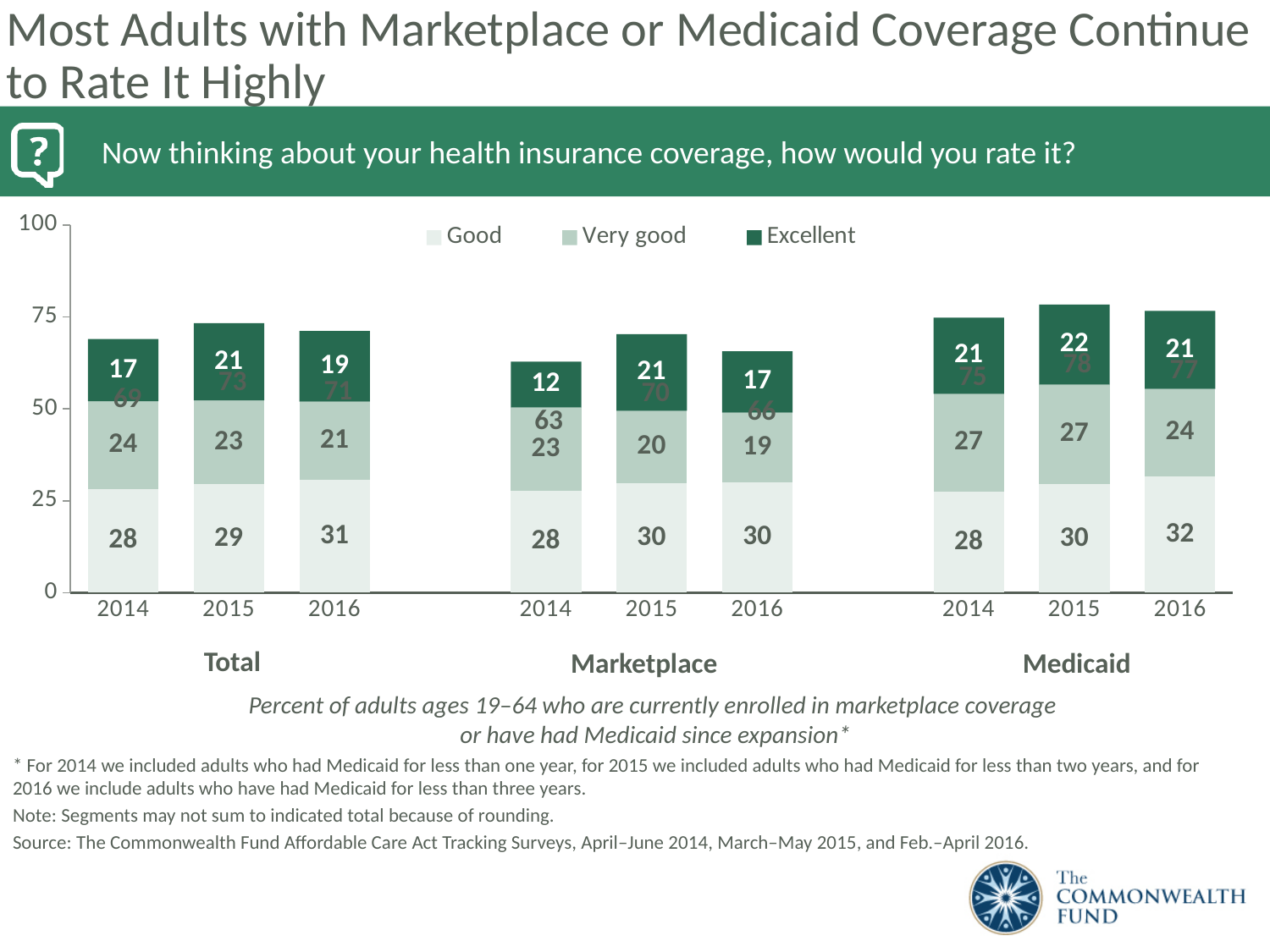
What is the total of the stacked bar for Total in 2014? 69 Which year has the lowest 'Excellent' value in the Marketplace group? 2014 What is the total of the stacked bar for Marketplace in 2016? 66 What is the difference between the 'Very good' values for Medicaid 2014 and Marketplace 2014? 4 What is the 'Good' value for Medicaid in 2016? 32 What is the 'Excellent' value for Marketplace in 2014? 12 Which year has the highest 'Excellent' value in the Medicaid group? 2015 What kind of chart is shown on the slide? Stacked bar chart What is the 'Very good' value for Total in 2015? 23 Does the 'Good' value for Total rise or fall from 2014 to 2016? Rise Which is larger, the 'Good' value for Total in 2016 or for Marketplace in 2016? Total in 2016 How many series does the legend list? 3